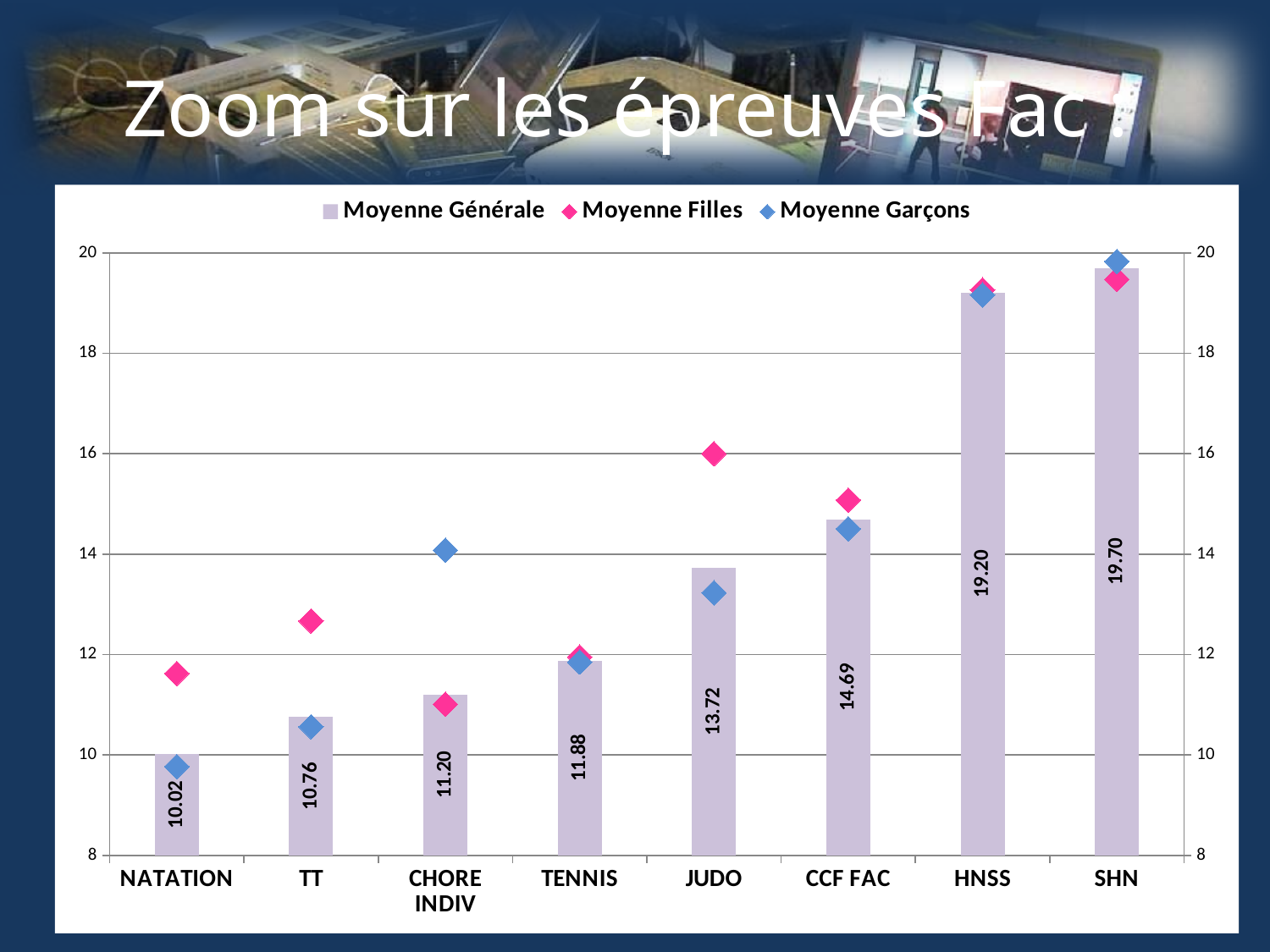
Is the Moyenne Filles value for JUDO greater or less than 14? greater Which has a higher Moyenne Générale, TENNIS or TT? TENNIS How many series does the legend list? 3 How many categories are shown on the x axis? 8 What is the difference between the Moyenne Générale for SHN and for HNSS? 0.50 Do the Moyenne Générale values rise or fall from NATATION to SHN along the x axis? rise Is the Moyenne Garçons value for CHORE INDIV greater or less than 12? greater What is the Moyenne Générale value for JUDO? 13.72 What is the Moyenne Générale value for CCF FAC? 14.69 Which category has the lowest Moyenne Générale? NATATION Which category has the highest Moyenne Générale? SHN What is the Moyenne Générale value for NATATION? 10.02